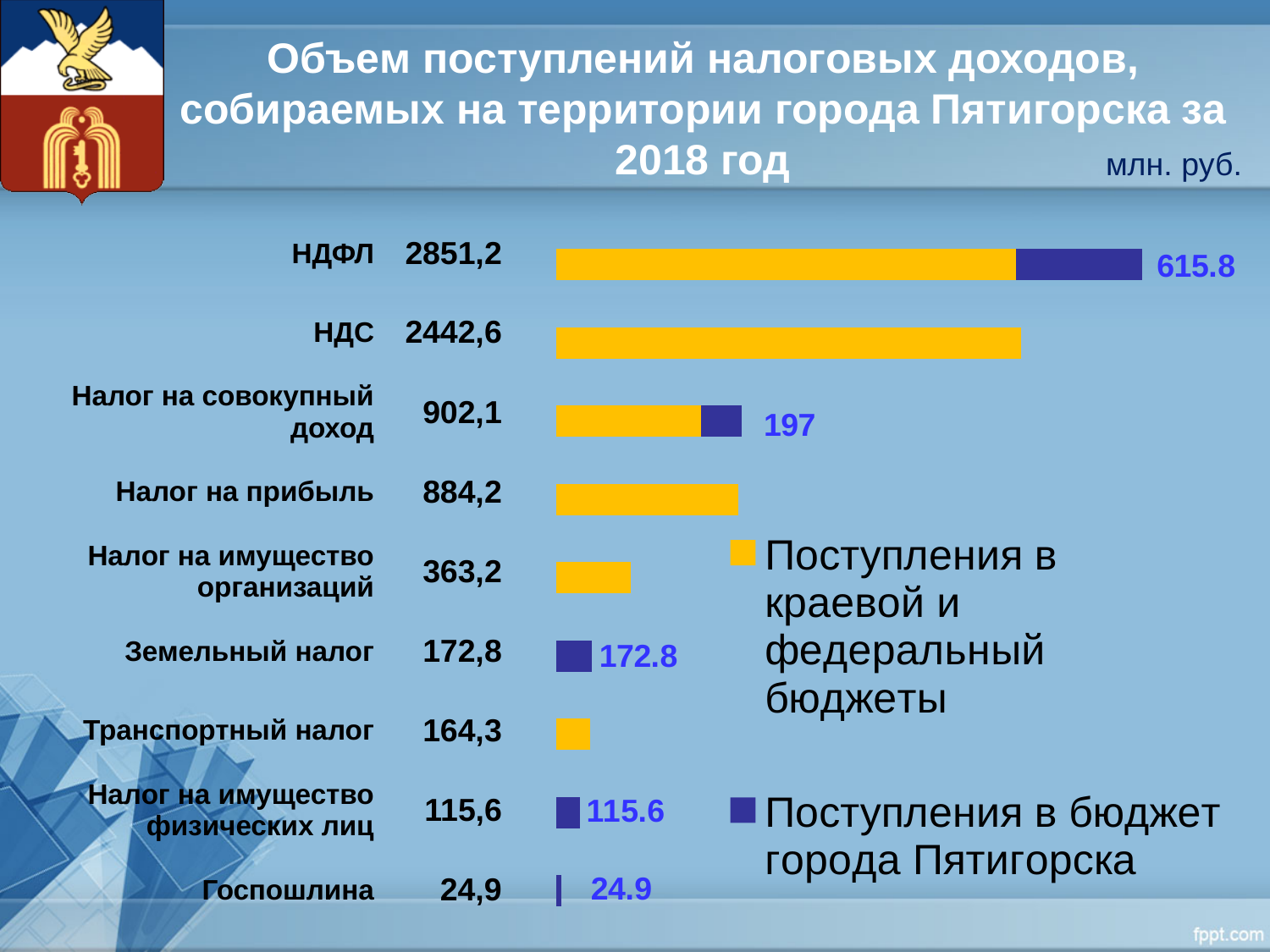
What value is labelled on the blue segment for Налог на совокупный доход? 197 How many series does the legend list? 2 What value is labelled on the blue segment (Поступления в бюджет города Пятигорска) for НДФЛ? 615.8 What type of chart is shown on the slide? Bar chart Which category has the lowest total value? Госпошлина What is the value shown for НДС? 2442,6 What is the total tax revenue value shown for НДФЛ? 2851,2 How many tax categories are shown in the chart? 9 What is the value shown for Госпошлина? 24,9 Which is larger, the value for Налог на совокупный доход or Налог на прибыль? Налог на совокупный доход Which category has the highest total value? НДФЛ What is the difference between the totals for НДФЛ and НДС? 408,6